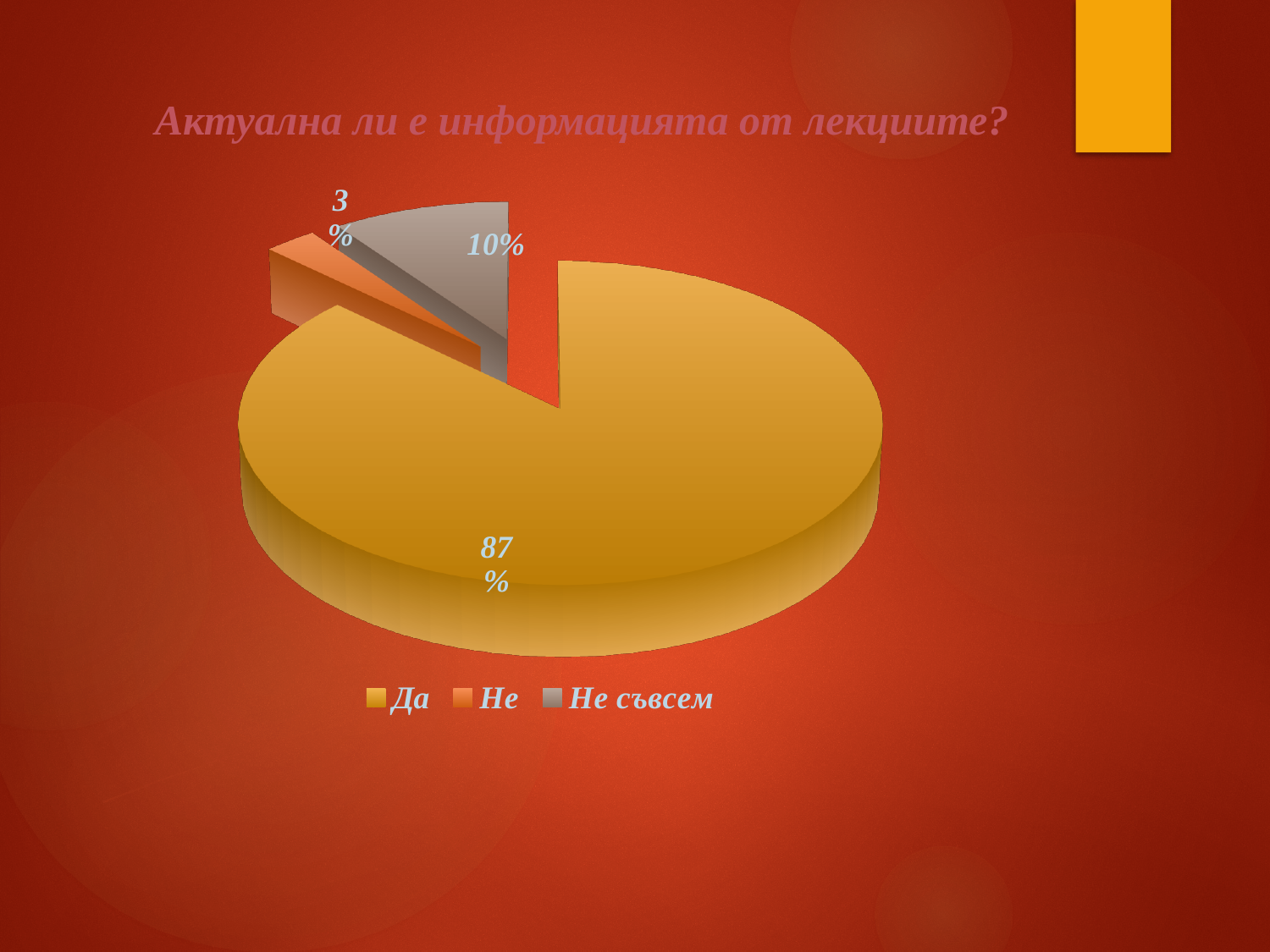
What colour is the slice for "Не съвсем"? grey What share of the pie does "Да" have? 87% Which is larger, the share for "Не съвсем" or the share for "Не"? Не съвсем Which category has the largest slice? Да How many categories does the pie chart have? 3 What is the difference between the shares of "Да" and "Не съвсем"? 77% What is the title of the chart? Актуална ли е информацията от лекциите? What share of the pie does "Не" have? 3% What is the difference between the shares of "Не съвсем" and "Не"? 7% What kind of chart is shown on the slide? pie chart What share of the pie does "Не съвсем" have? 10% Which category has the smallest slice? Не